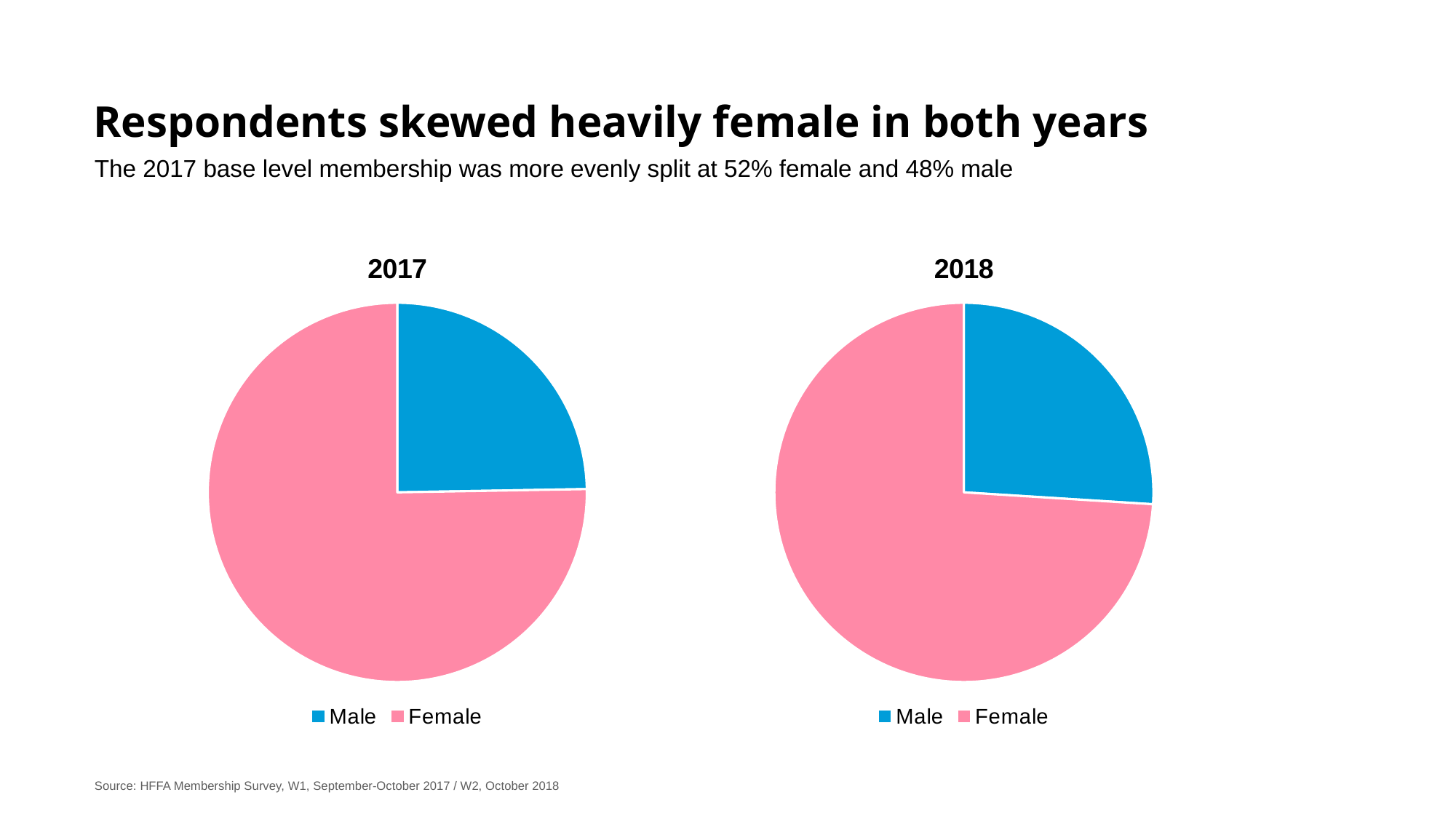
In the 2018 chart, which category has the largest slice? Female In the 2017 chart, which slice is larger, Male or Female? Female In the 2017 chart, which category has the largest slice? Female How many slices does the 2017 pie chart have? 2 What kind of chart is the 2018 chart? pie chart In the 2018 chart, which slice is larger, Male or Female? Female How many entries does the legend of the 2018 chart list? 2 What kind of chart is the 2017 chart? pie chart In the 2018 chart, which category has the smallest slice? Male What is the title of the chart on the left? 2017 In the 2017 chart, which category has the smallest slice? Male In the 2018 chart, what colour is the Male slice? blue